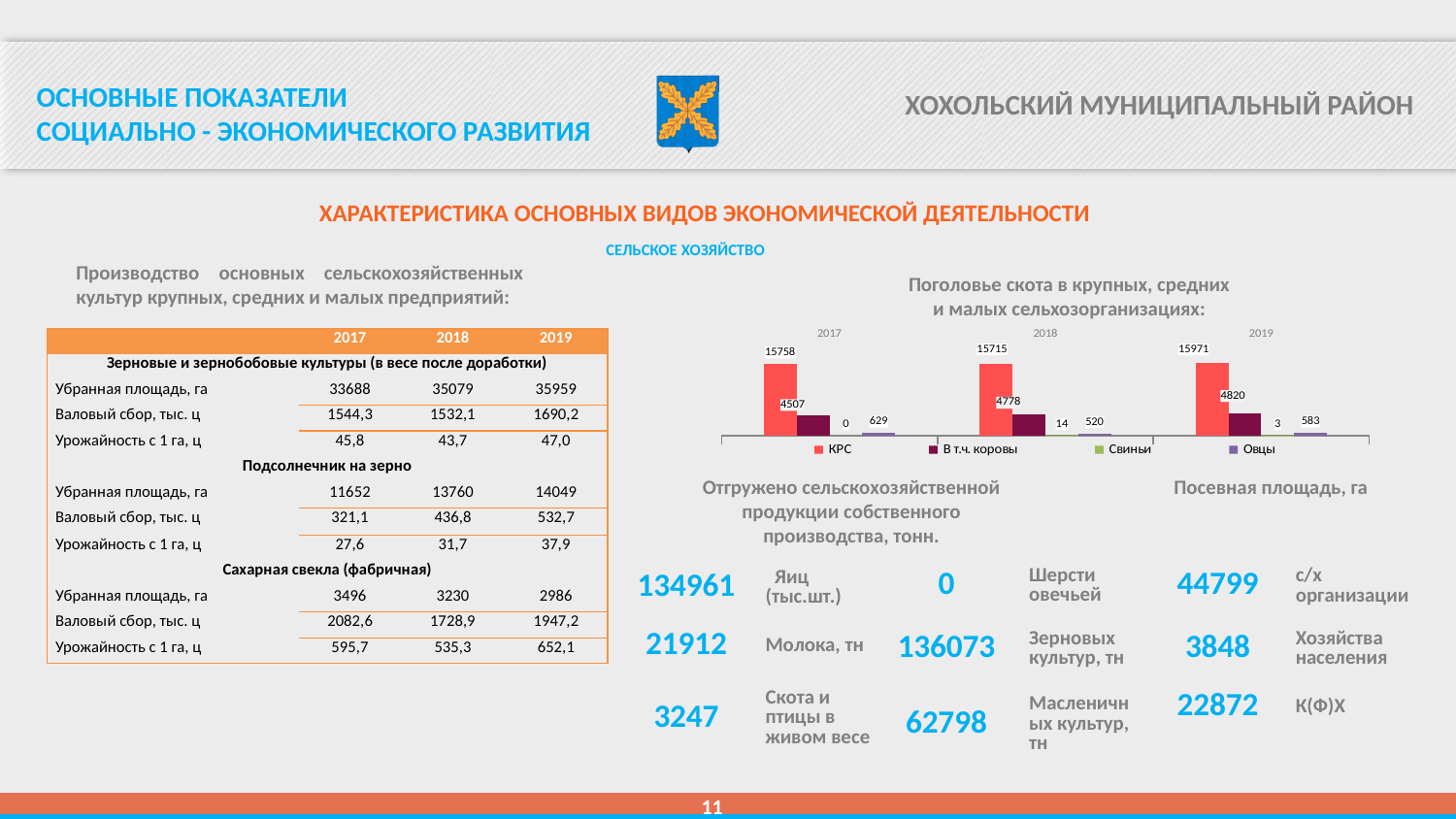
What is the difference between the КРС values for 2019 and 2018 on the livestock chart? 256 What is the value for Овцы in 2019 on the livestock chart? 583 What is the value for Свиньи in 2017 on the livestock chart? 0 What is the value for КРС in 2019 on the livestock chart? 15971 How many years are shown on the x axis of the livestock chart? 3 How many series does the legend of the livestock chart list? 4 What kind of chart is the livestock chart? bar chart In which year is the Овцы value lowest on the livestock chart? 2018 What is the title of the chart on the slide? Поголовье скота в крупных, средних и малых сельхозорганизациях In which year is the КРС value highest on the livestock chart? 2019 What is the value for В т.ч. коровы in 2018 on the livestock chart? 4778 Which is larger on the livestock chart: Овцы in 2017 or Овцы in 2019? Овцы in 2017